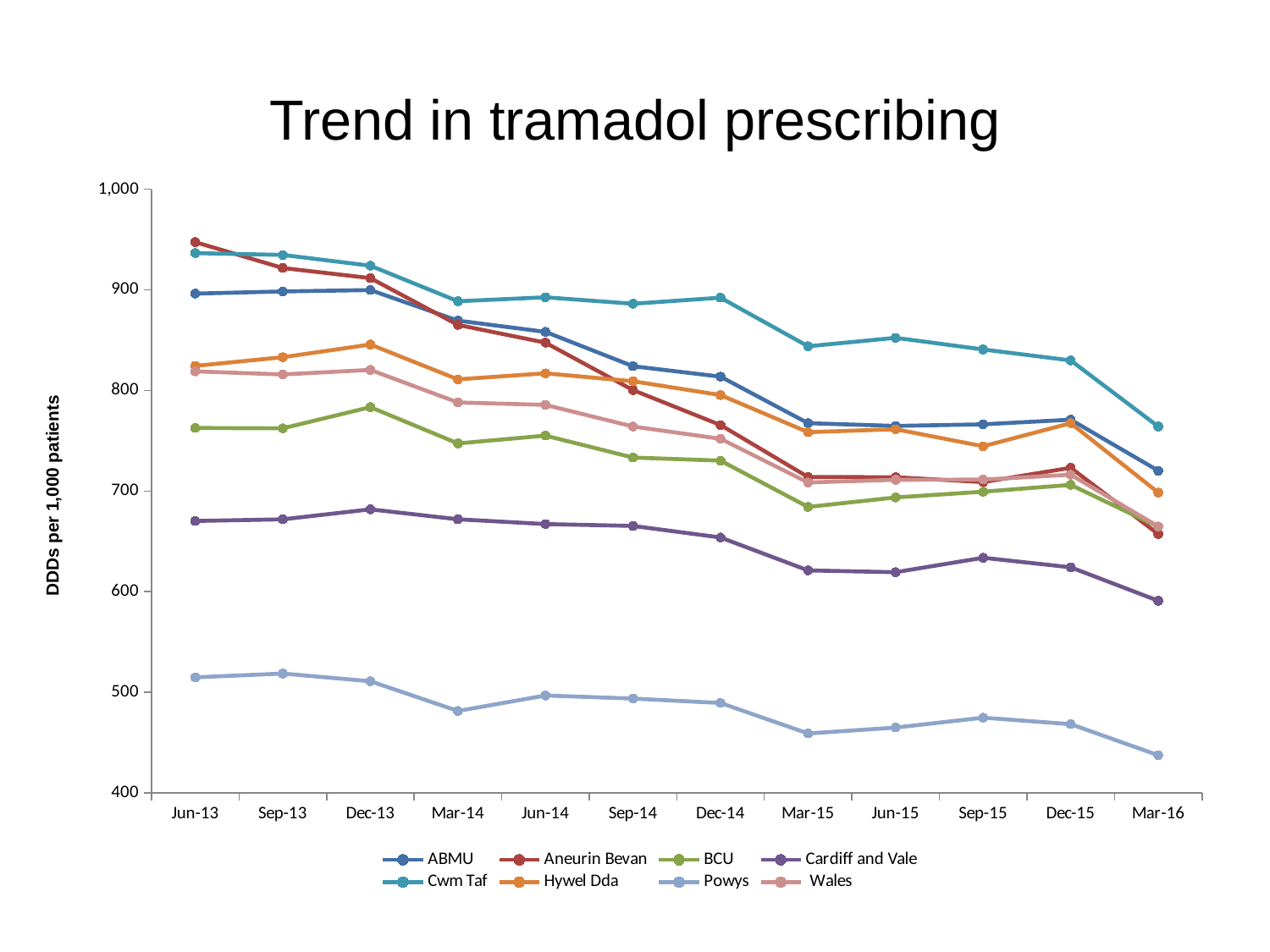
How many time points are shown along the x axis? 12 Do the values for Cwm Taf generally rise or fall from Jun-13 to Mar-16? fall Is the value for Cardiff and Vale at Dec-13 greater or less than 700? less Is the value for Cwm Taf at Jun-13 greater or less than 900? greater Which series has the lowest value at Mar-16? Powys What kind of chart is shown on the slide? line chart Is the value for Powys at Mar-16 greater or less than 500? less Which series has the highest value at Mar-16? Cwm Taf Which series has the highest value at Dec-15? Cwm Taf What is the label on the y axis? DDDs per 1,000 patients At Sep-14, which is larger: the value for Cwm Taf or the value for Powys? Cwm Taf How many series does the legend list? 8